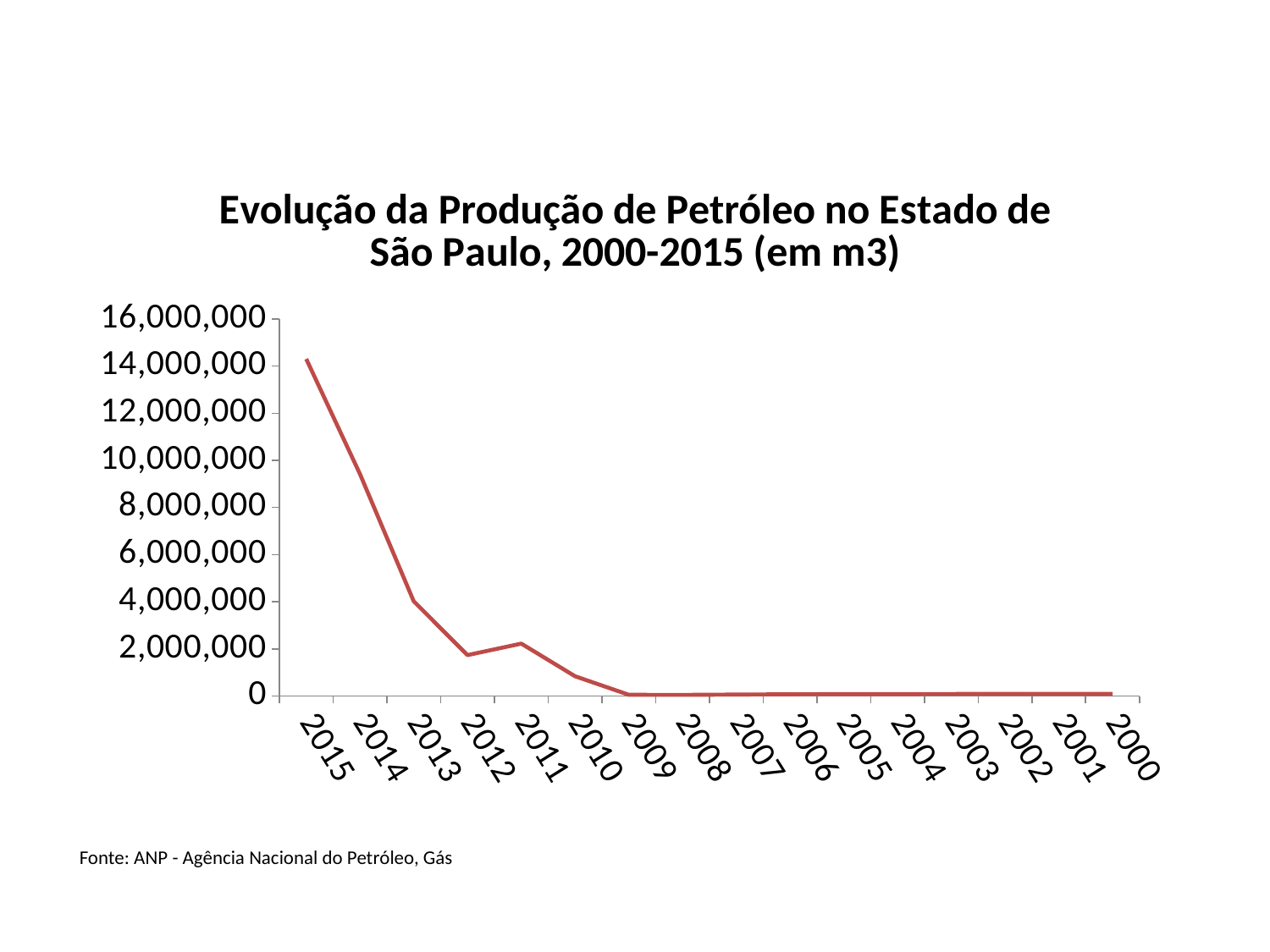
Is the value for 2014 greater or less than 8,000,000? greater What is the title of the chart? Evolução da Produção de Petróleo no Estado de São Paulo, 2000-2015 (em m3) How many years are plotted along the x axis of the chart? 16 Is the value for 2005 greater or less than 2,000,000? less Moving from left to right along the x axis (from 2015 to 2000), do the values generally rise or fall? fall What kind of chart is shown on the slide? line chart Which year has the highest oil production value in the chart? 2015 Is the value for 2013 greater or less than 2,000,000? greater Which is larger, the value for 2015 or the value for 2014? 2015 Which is larger, the value for 2011 or the value for 2012? 2011